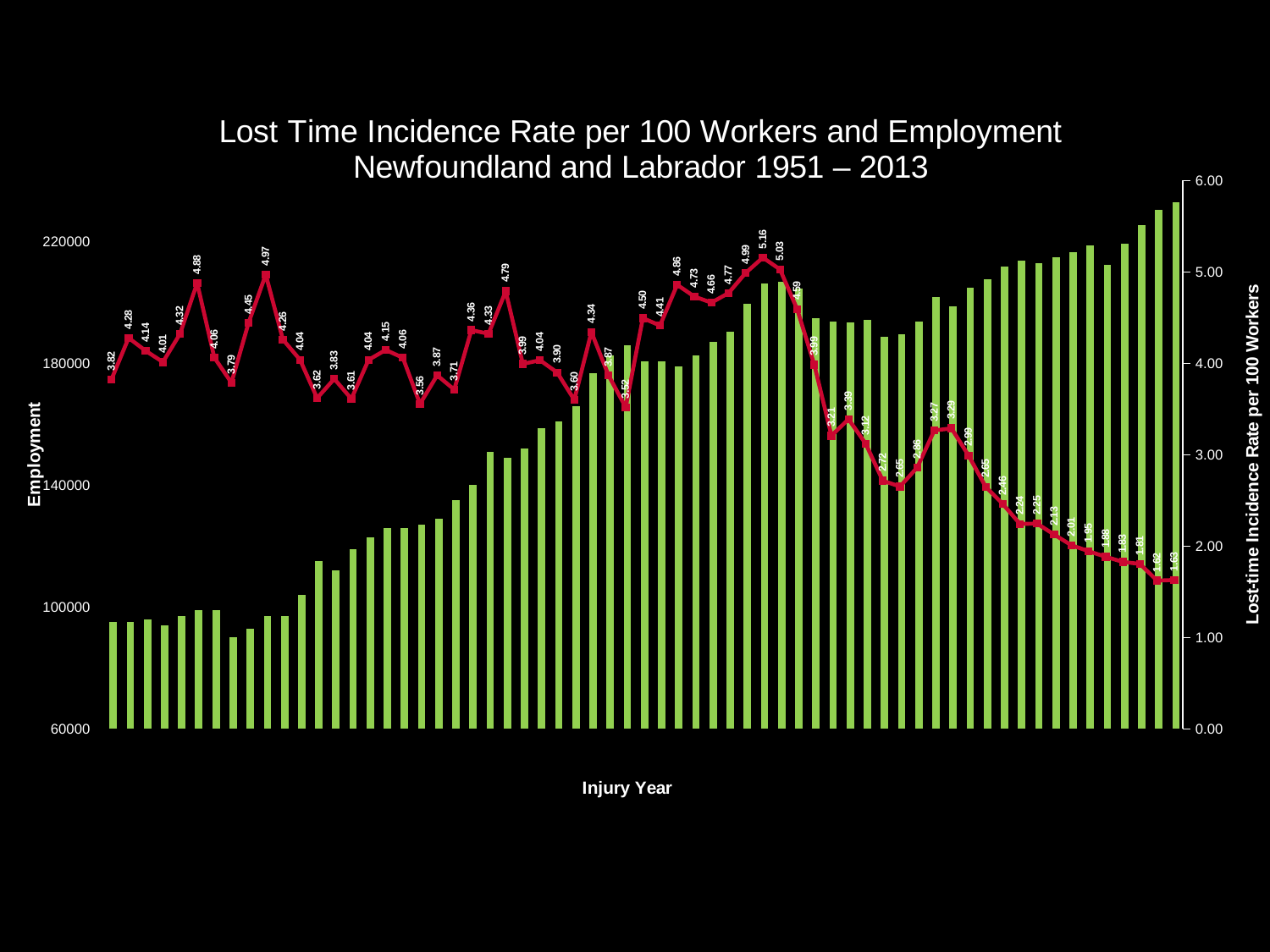
How many injury years does the chart cover, according to its title (1951 – 2013)? 63 What is the difference between the highest (5.16) and lowest (1.62) incidence rate values labelled on the line? 3.54 Do the green employment bars generally rise or fall from left to right across the chart? Rise Is the employment value for the shortest bar greater or less than 100000? less What is the lowest lost-time incidence rate value labelled on the red line? 1.62 What is the label of the right-hand vertical axis? Lost-time Incidence Rate per 100 Workers What kind of chart is shown on the slide? A bar chart combined with a line chart Which is larger, the labelled incidence rate peak of 4.88 or the peak of 4.97? 4.97 What is the highest lost-time incidence rate value labelled on the red line? 5.16 Does the red incidence rate line rise or fall over the right-hand portion of the chart after its peak of 5.16? Fall Is the employment value for the last (rightmost) bar greater or less than 220000? greater What is the label of the horizontal axis? Injury Year